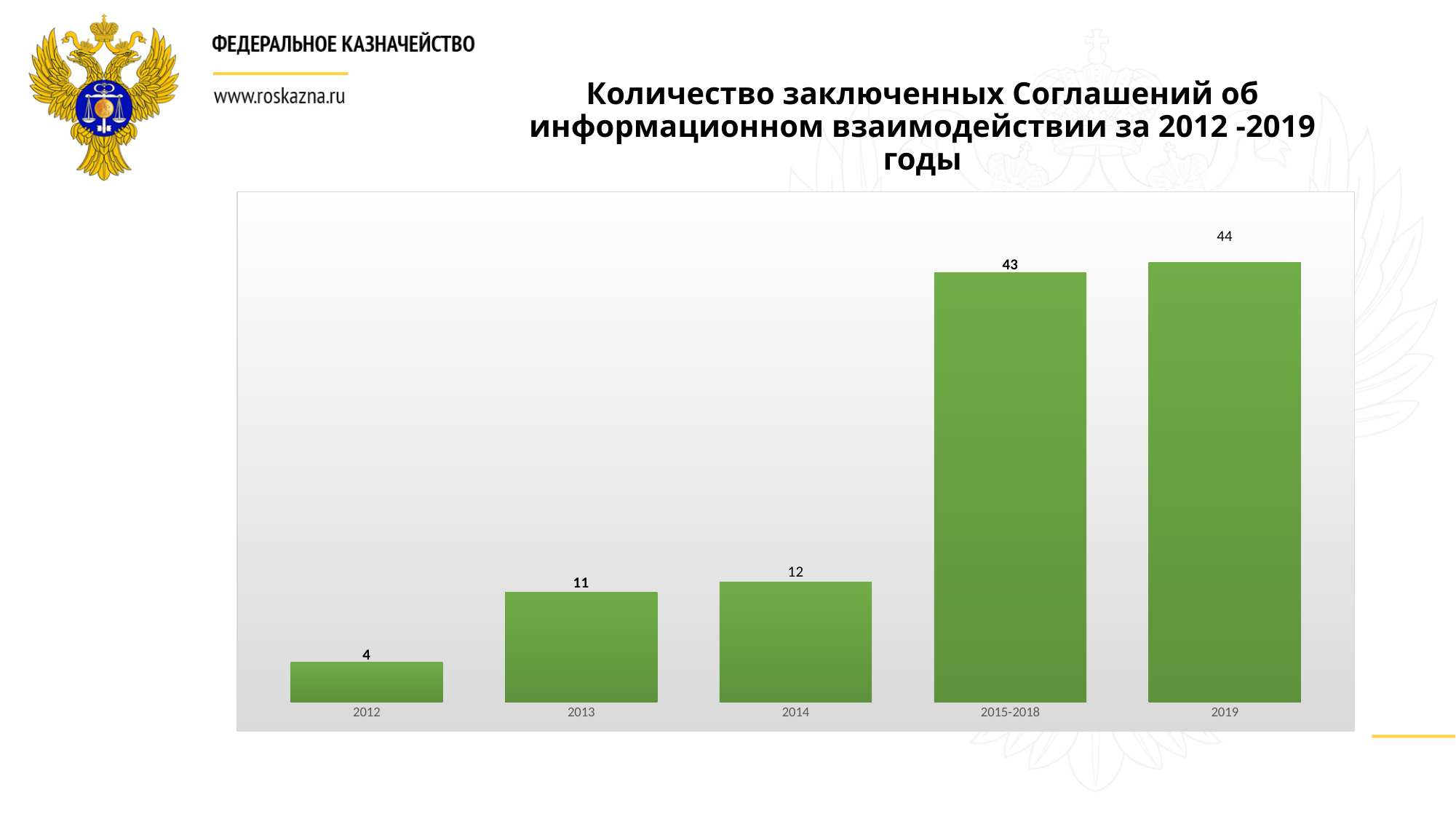
Do the values rise or fall from 2012 to 2019 along the x axis? rise Which category has the lowest value? 2012 Which is larger, the value for 2013 or the value for 2014? 2014 What is the difference between the values for 2019 and 2012? 40 What is the value for 2019? 44 How many categories are shown on the x axis? 5 What is the value for 2013? 11 What is the value for 2012? 4 What kind of chart is shown on the slide? bar chart What is the value for 2014? 12 What is the value for 2015-2018? 43 Which category has the highest value? 2019